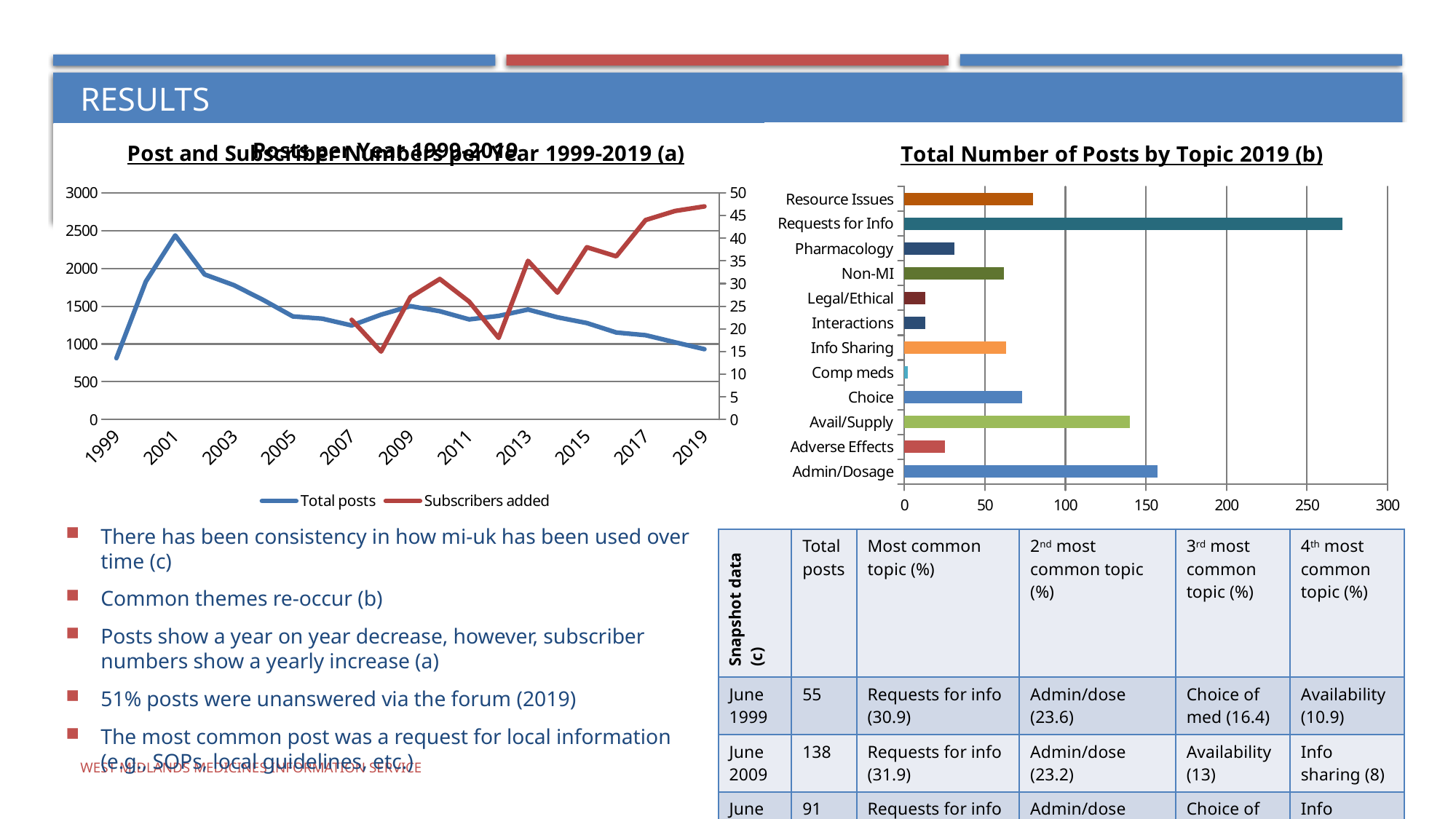
In the 'Total Number of Posts by Topic 2019 (b)' chart, is the value for Requests for Info greater or less than 250? greater In the 'Post and Subscriber Numbers per Year 1999-2019 (a)' chart, in which year is the Total posts value highest? 2001 In the 'Total Number of Posts by Topic 2019 (b)' chart, which topic has the highest number of posts? Requests for Info In the 'Total Number of Posts by Topic 2019 (b)' chart, which topic has the lowest number of posts? Comp meds What kind of chart is 'Total Number of Posts by Topic 2019 (b)'? bar chart In the 'Total Number of Posts by Topic 2019 (b)' chart, is the value for Pharmacology greater or less than 50? less How many topics are shown in the 'Total Number of Posts by Topic 2019 (b)' chart? 12 In the 'Total Number of Posts by Topic 2019 (b)' chart, which has more posts, Non-MI or Pharmacology? Non-MI In the 'Total Number of Posts by Topic 2019 (b)' chart, is the value for Admin/Dosage greater or less than 150? greater In the 'Total Number of Posts by Topic 2019 (b)' chart, which has more posts, Admin/Dosage or Avail/Supply? Admin/Dosage How many series does the legend of the 'Post and Subscriber Numbers per Year 1999-2019 (a)' chart list? 2